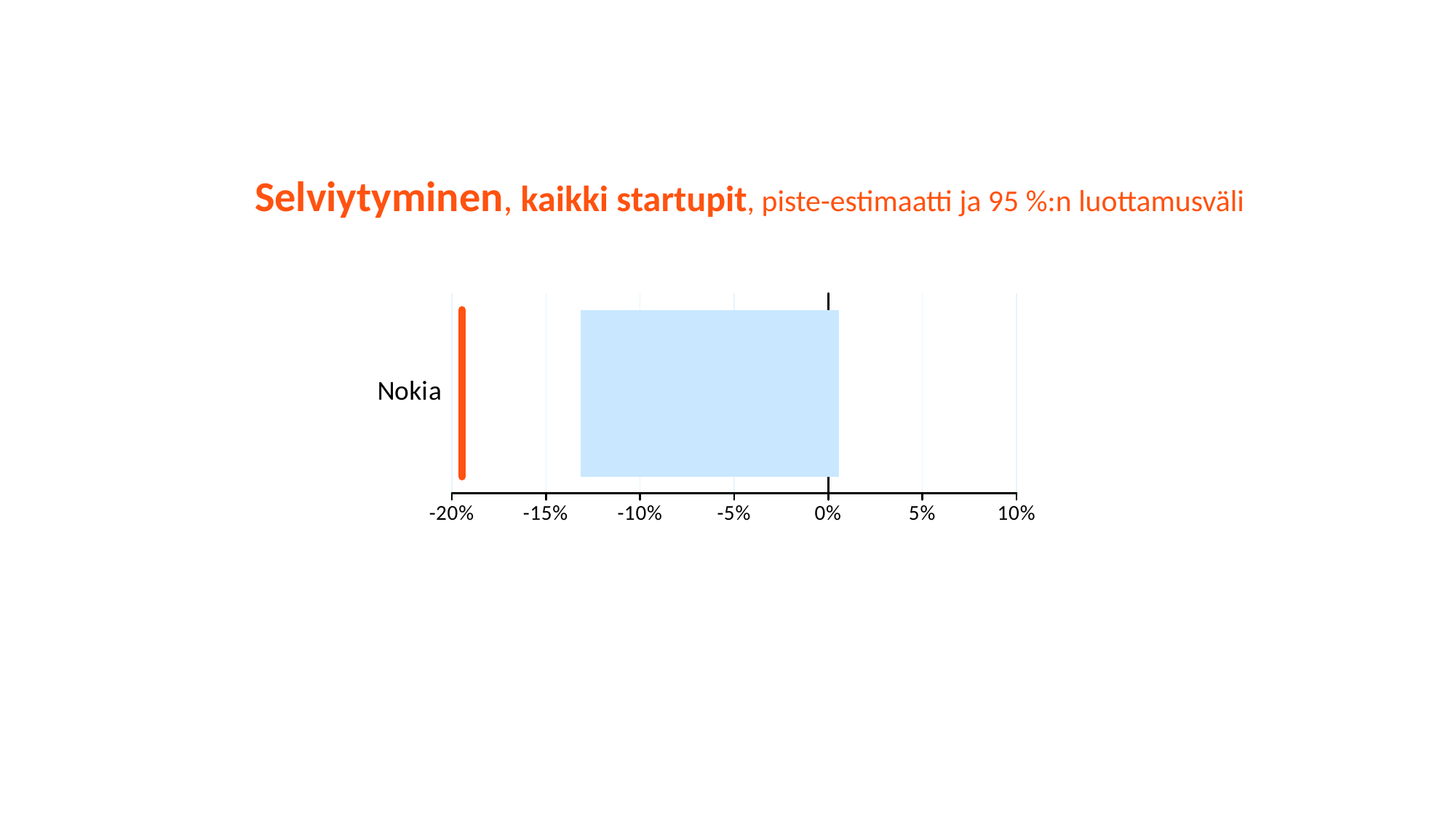
Is the left edge of the light blue confidence interval for Nokia greater or less than -10%? less What is the highest value labelled on the horizontal axis? 10% Is the right edge of the light blue confidence interval for Nokia greater or less than 5%? less What is the name of the category shown on the chart? Nokia Is the orange point estimate marker for Nokia greater or less than -10%? less What is the lowest value labelled on the horizontal axis? -20% What kind of chart is shown on the slide? bar chart What is the title of the chart? Selviytyminen, kaikki startupit, piste-estimaatti ja 95 %:n luottamusväli How many categories are shown on the chart's vertical axis? 1